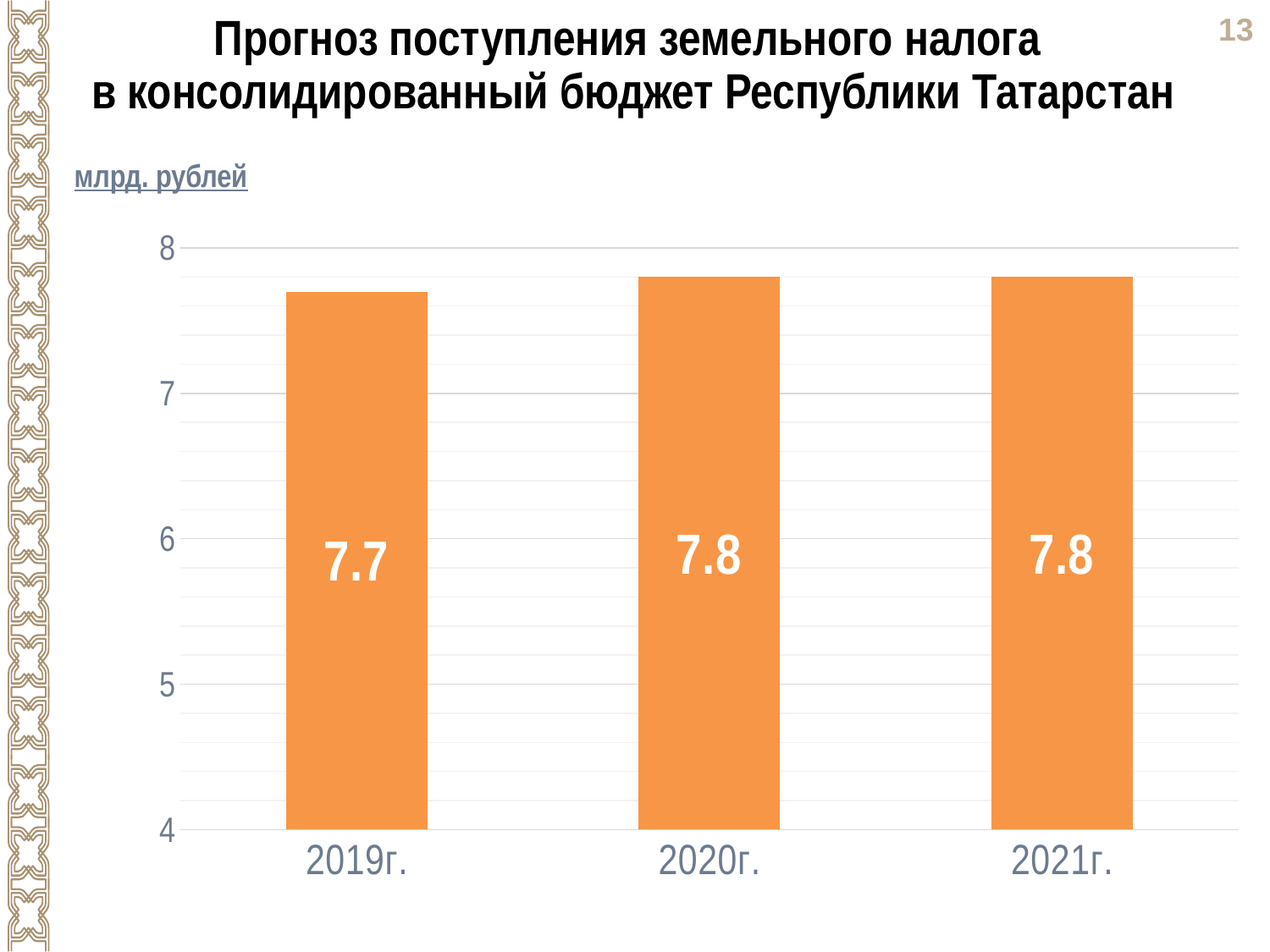
Is the value for 2020г. greater or less than 8? less What unit of measurement is indicated for the chart? млрд. рублей Is the value for 2019г. greater or less than 7? greater Which is larger, the value for 2019г. or the value for 2021г.? 2021г. How many years are shown on the chart? 3 What is the difference between the values for 2020г. and 2019г.? 0.1 Do the values rise or fall from 2019г. to 2020г.? rise What kind of chart is shown on the slide? bar chart Which year has the lowest forecast value? 2019г. What is the forecast land tax revenue for 2020г.? 7.8 What is the forecast land tax revenue for 2019г.? 7.7 What is the forecast land tax revenue for 2021г.? 7.8